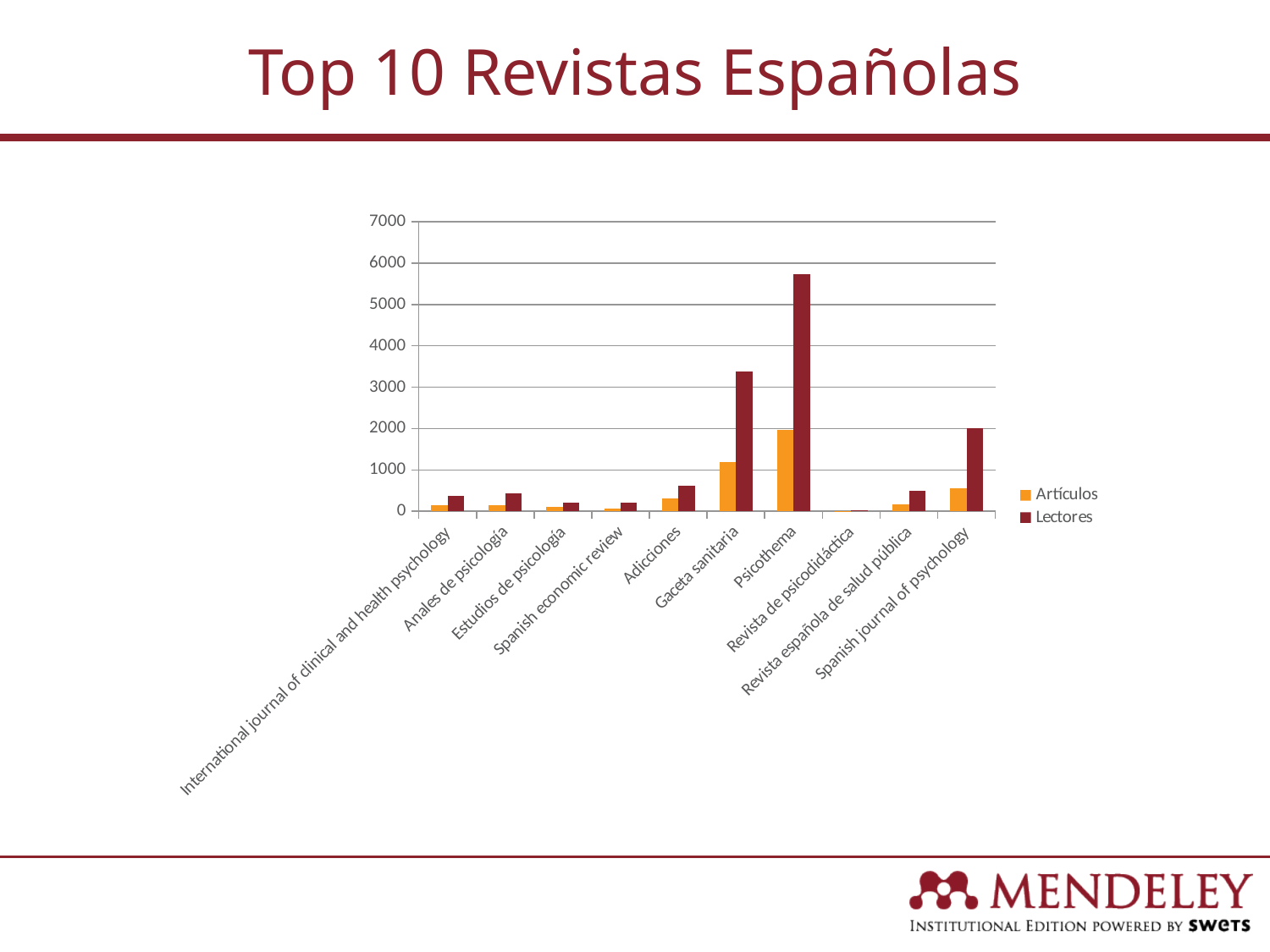
Is the Lectores value for Gaceta sanitaria greater or less than 3000? greater Is the Lectores value for Psicothema greater or less than 5000? greater Which journal has the highest Lectores value? Psicothema How many series does the legend list? 2 How many journals (categories) are shown on the x axis? 10 Which journal has the lowest Lectores value? Revista de psicodidáctica For Psicothema, which series has the larger value, Artículos or Lectores? Lectores Which has a larger Lectores value, Gaceta sanitaria or Adicciones? Gaceta sanitaria Is the Artículos value for Psicothema greater or less than 1000? greater Which journal has the highest Artículos value? Psicothema What kind of chart is shown on the slide? bar chart What is the title of the slide containing the chart? Top 10 Revistas Españolas